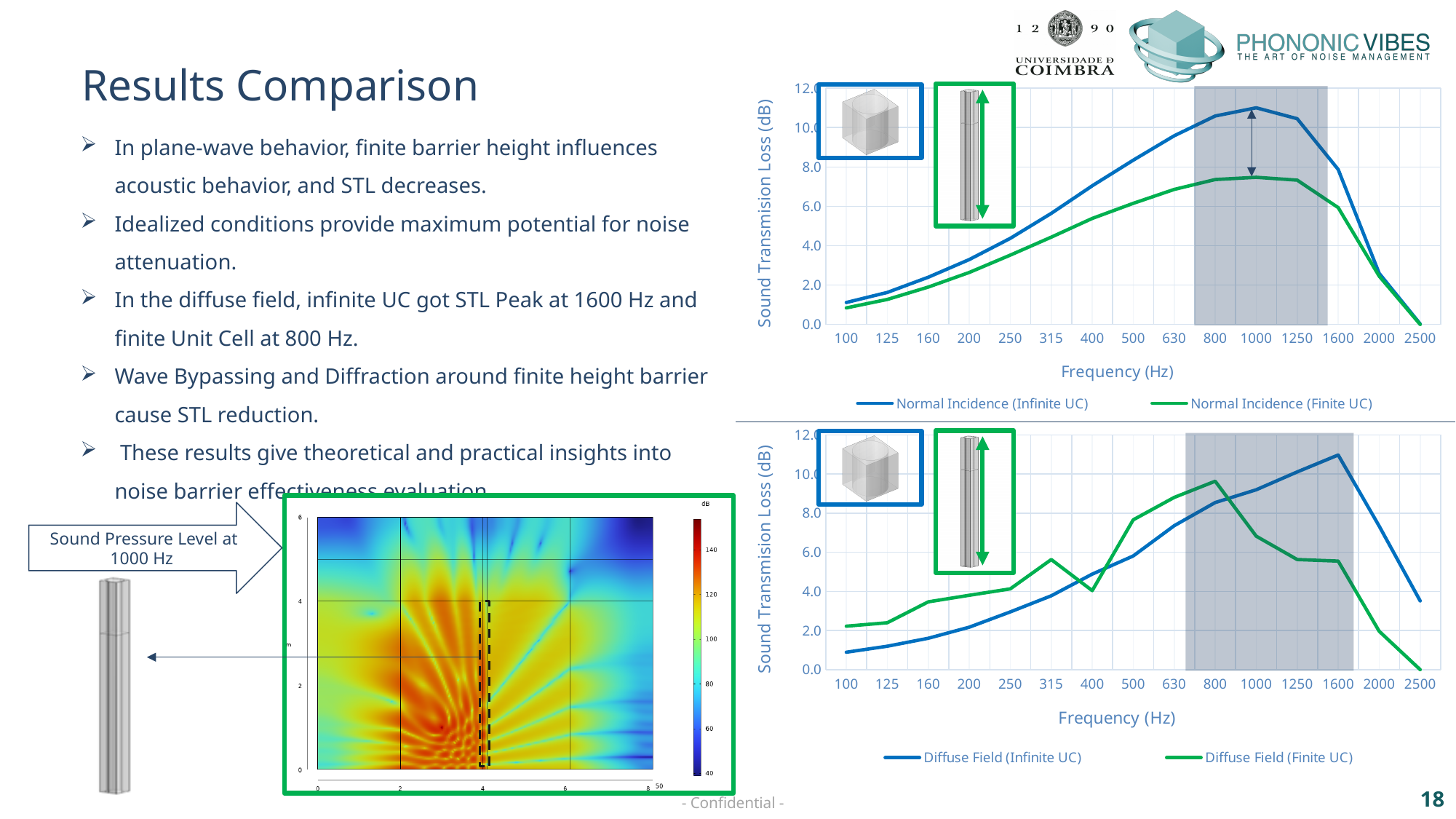
In the bottom chart, is the value of Diffuse Field (Infinite UC) at 100 Hz greater or less than 2.0? less In the top chart, is the value of Normal Incidence (Finite UC) at 1000 Hz greater or less than 8.0? less What kind of chart is the top chart on the right of the slide? line chart How many series does the legend of the bottom chart list? 2 How many frequency values are labelled on the x axis of the top chart? 15 What is the y-axis title of the bottom chart? Sound Transmision Loss (dB) In the top chart, does the Normal Incidence (Infinite UC) series rise or fall between 100 Hz and 1000 Hz? rise In the bottom chart, at 800 Hz, which series has the larger value: Diffuse Field (Infinite UC) or Diffuse Field (Finite UC)? Diffuse Field (Finite UC) In the bottom chart, at which frequency does the Diffuse Field (Infinite UC) series reach its highest value? 1600 In the top chart, is the value of Normal Incidence (Infinite UC) at 1000 Hz greater or less than 10.0? greater In the bottom chart, at which frequency does the Diffuse Field (Finite UC) series reach its highest value? 800 In the top chart, at which frequency does the Normal Incidence (Infinite UC) series reach its highest value? 1000